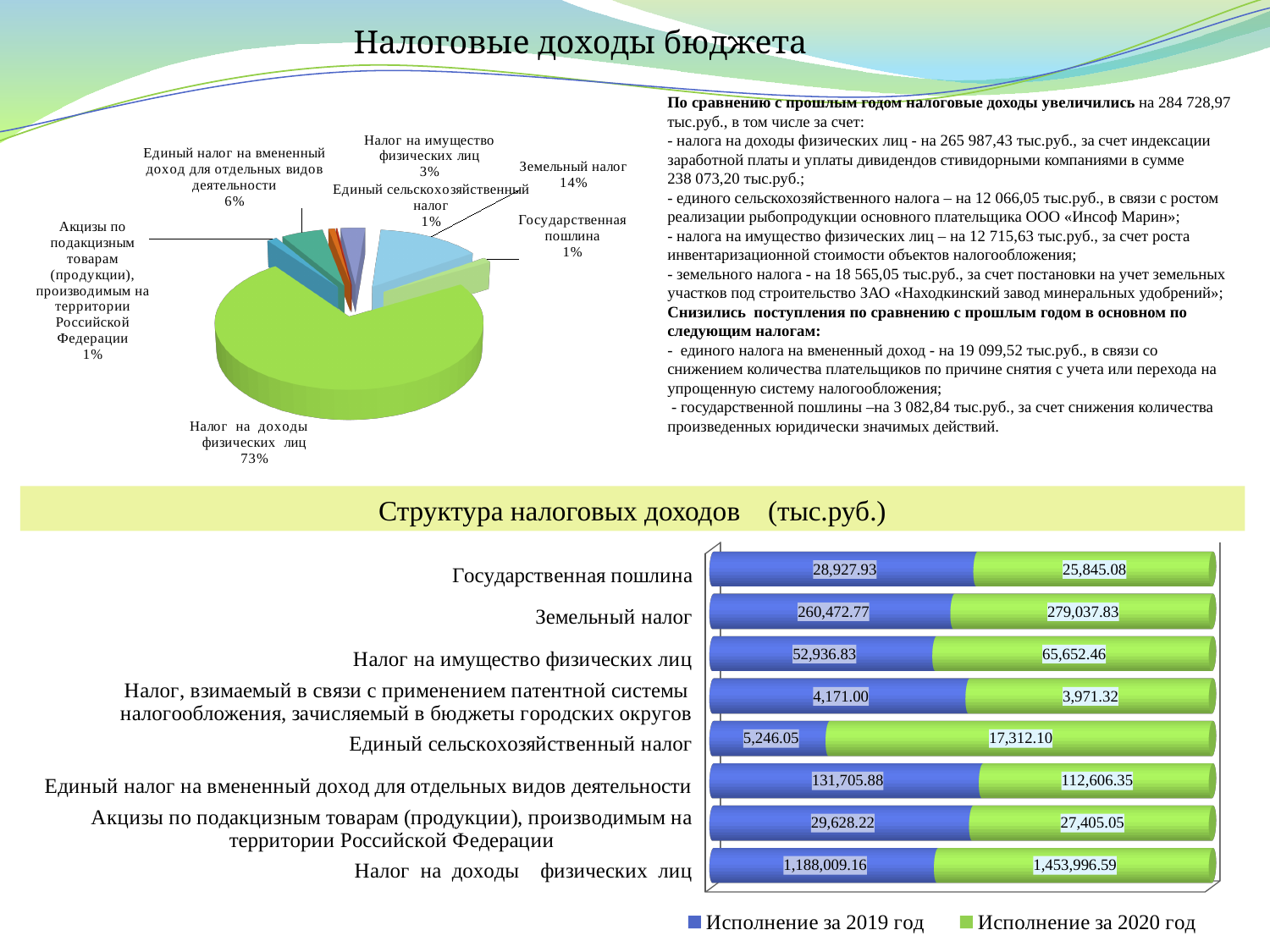
In the chart 'Структура налоговых доходов (тыс.руб.)', what kind of chart is it? bar chart In the chart 'Структура налоговых доходов (тыс.руб.)', what is the difference between Исполнение за 2020 год and Исполнение за 2019 год for Единый сельскохозяйственный налог? 12,066.05 In the chart 'Структура налоговых доходов (тыс.руб.)', how many series does the legend list? 2 In the chart 'Структура налоговых доходов (тыс.руб.)', which is larger for Единый налог на вмененный доход для отдельных видов деятельности: Исполнение за 2019 год or Исполнение за 2020 год? Исполнение за 2019 год In the chart 'Структура налоговых доходов (тыс.руб.)', what is the difference between Исполнение за 2020 год and Исполнение за 2019 год for Налог на имущество физических лиц? 12,715.63 In the pie chart, how many slices are there? 7 In the chart 'Структура налоговых доходов (тыс.руб.)', what is the value of Исполнение за 2019 год for Земельный налог? 260,472.77 In the chart 'Структура налоговых доходов (тыс.руб.)', what is the value of Исполнение за 2020 год for Налог на доходы физических лиц? 1,453,996.59 In the pie chart, what share does Земельный налог have? 14% In the pie chart, what share does Налог на доходы физических лиц have? 73% In the pie chart, what kind of chart is it? pie chart In the pie chart, which category has the largest slice? Налог на доходы физических лиц